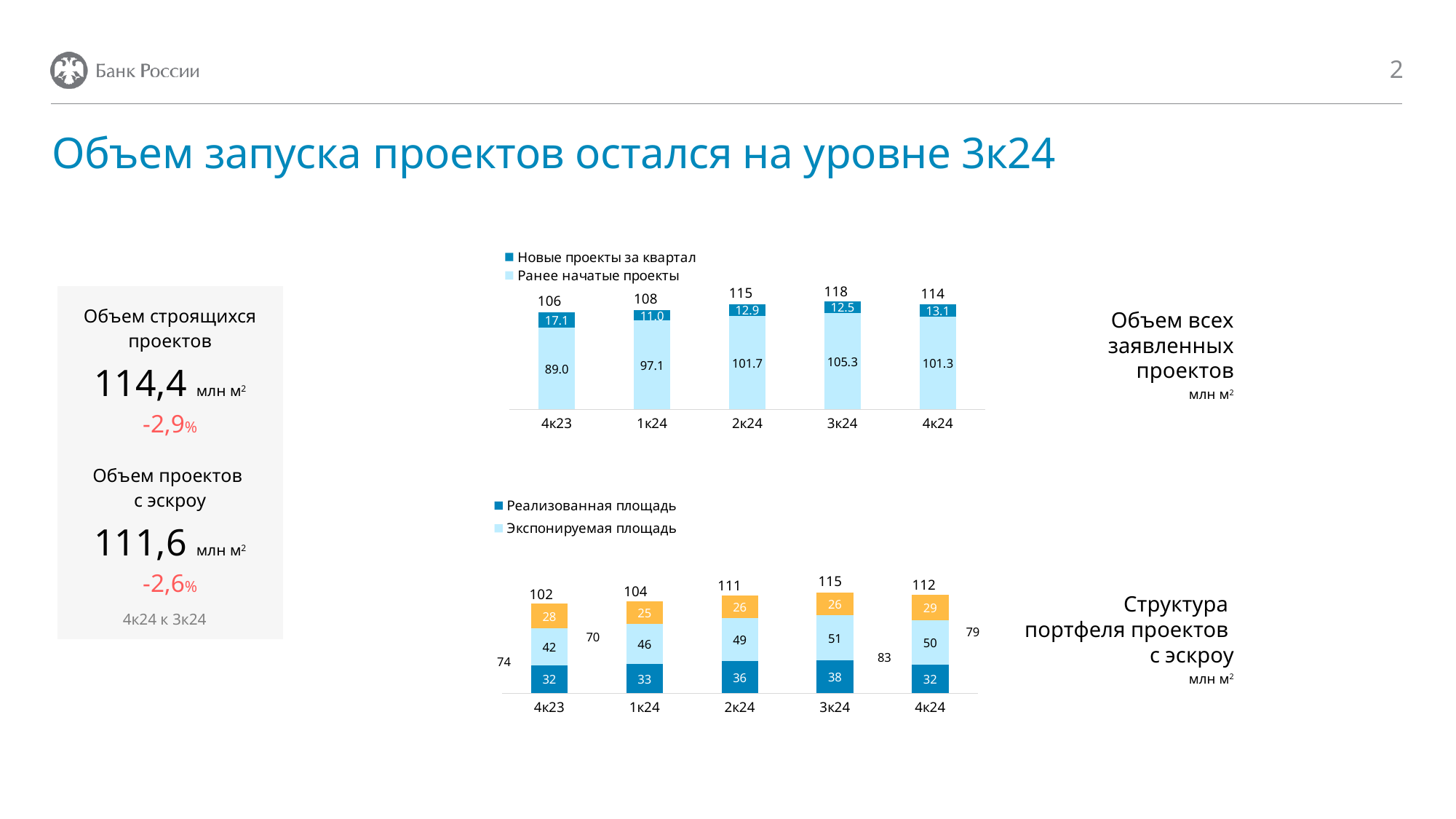
In the bottom chart (Структура портфеля проектов с эскроу), what is the value of Экспонируемая площадь for 1к24? 46 In the top chart (Объем всех заявленных проектов), what is the value of Ранее начатые проекты for 3к24? 105.3 In the top chart (Объем всех заявленных проектов), what is the total of the stacked bar for 2к24? 115 In the bottom chart (Структура портфеля проектов с эскроу), what is the value of Реализованная площадь for 3к24? 38 In the top chart (Объем всех заявленных проектов), what is the difference between the Новые проекты за квартал values for 4к23 and 1к24? 6.1 In the bottom chart (Структура портфеля проектов с эскроу), how many quarters are shown on the x axis? 5 In the top chart (Объем всех заявленных проектов), which quarter has the highest total? 3к24 In the top chart (Объем всех заявленных проектов), how many series does the legend list? 2 In the top chart (Объем всех заявленных проектов), which quarter has the lowest value for Ранее начатые проекты? 4к23 What type of chart is the bottom chart (Структура портфеля проектов с эскроу)? Stacked bar chart In the bottom chart (Структура портфеля проектов с эскроу), which is larger: Экспонируемая площадь for 2к24 or for 4к24? 4к24 In the top chart (Объем всех заявленных проектов), what is the value of Новые проекты за квартал for 4к24? 13.1